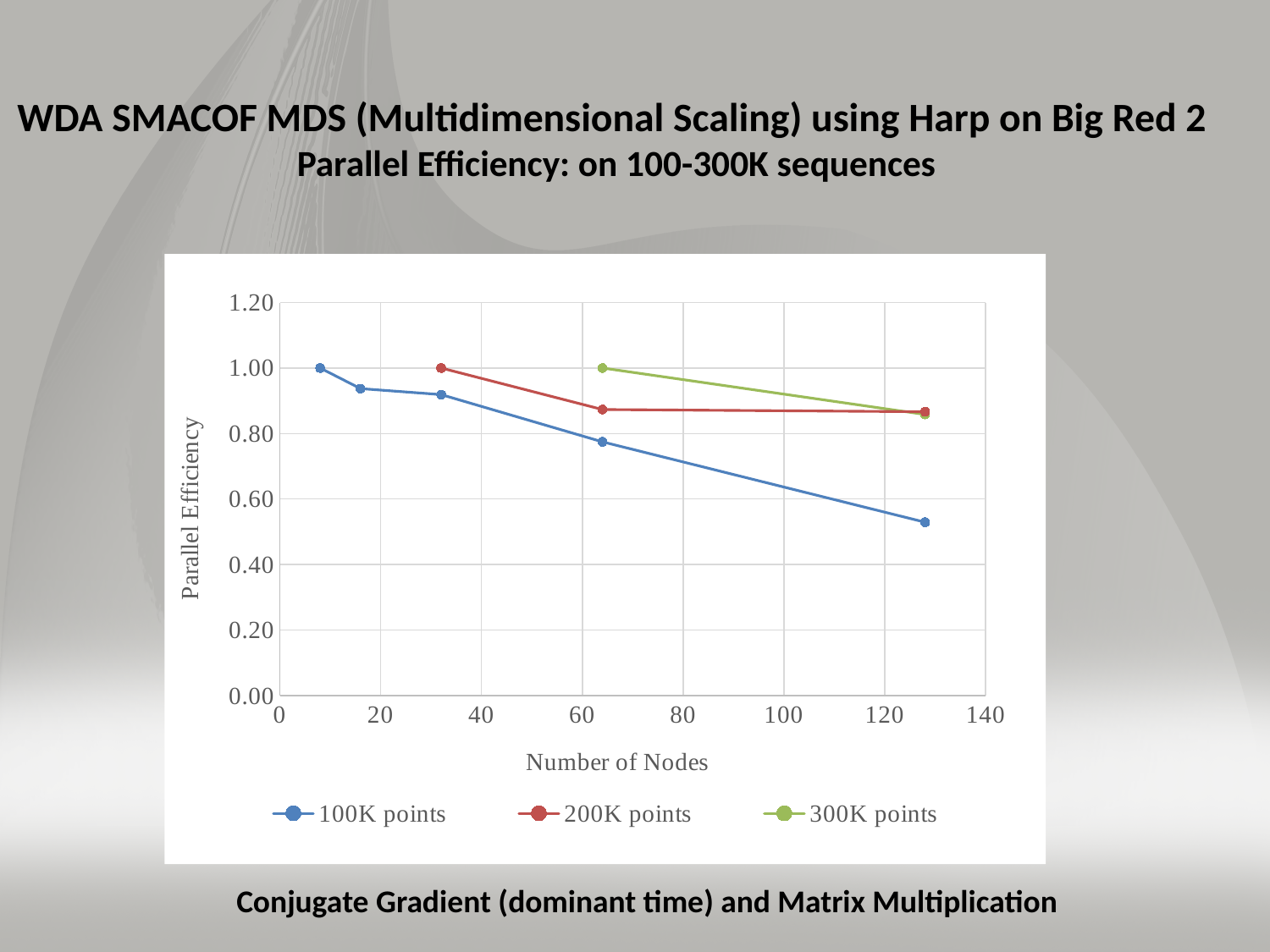
How many series does the legend list? 3 Is the parallel efficiency for 200K points at 128 nodes greater or less than 0.80? greater At 128 nodes, which series has the higher parallel efficiency: 100K points or 200K points? 200K points What is the label of the x axis? Number of Nodes Does the parallel efficiency of the 100K points series rise or fall as the number of nodes increases? fall Is the parallel efficiency for 100K points at 64 nodes greater or less than 0.60? greater What kind of chart is shown on the slide? line chart How many data points are plotted for the 100K points series? 5 Is the parallel efficiency for 100K points at 128 nodes greater or less than 0.60? less What is the parallel efficiency of the 200K points series at 32 nodes? 1.00 What is the parallel efficiency of the 100K points series at its first data point (8 nodes)? 1.00 What is the parallel efficiency of the 300K points series at 64 nodes? 1.00